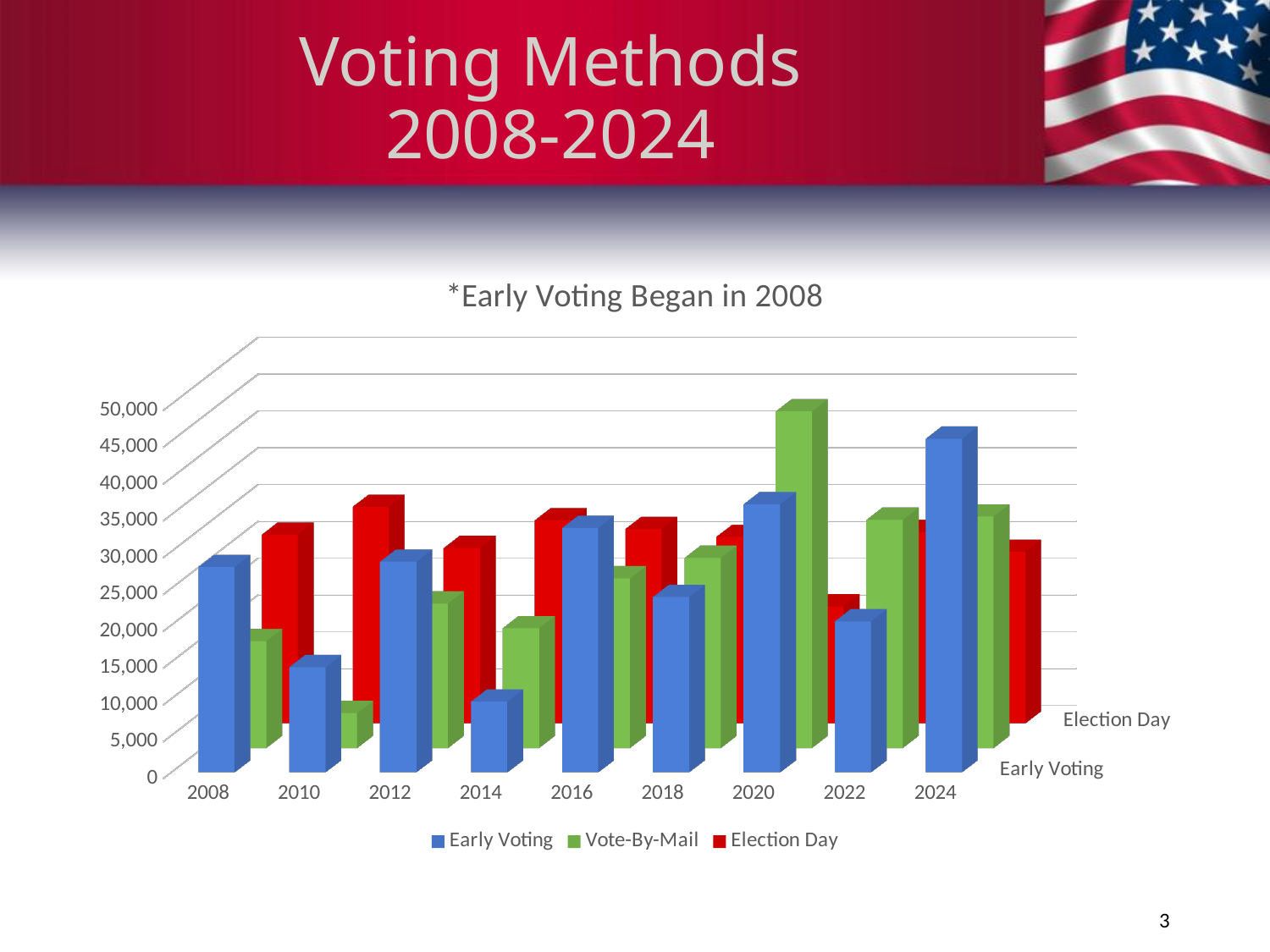
Is the Early Voting value for 2024 greater or less than 40,000? greater In which year is the Early Voting value lowest? 2014 In which year is the Early Voting value highest? 2024 How many series does the legend list? 3 In which year is the Vote-By-Mail value highest? 2020 Which is larger in 2020, Vote-By-Mail or Election Day? Vote-By-Mail In which year is the Vote-By-Mail value lowest? 2010 What kind of chart is shown on the slide? Bar chart What colour represents Election Day in the legend? Red How many election years are shown on the x axis? 9 Does the Early Voting value rise or fall from 2022 to 2024? Rise Is the Vote-By-Mail value for 2010 greater or less than 10,000? less